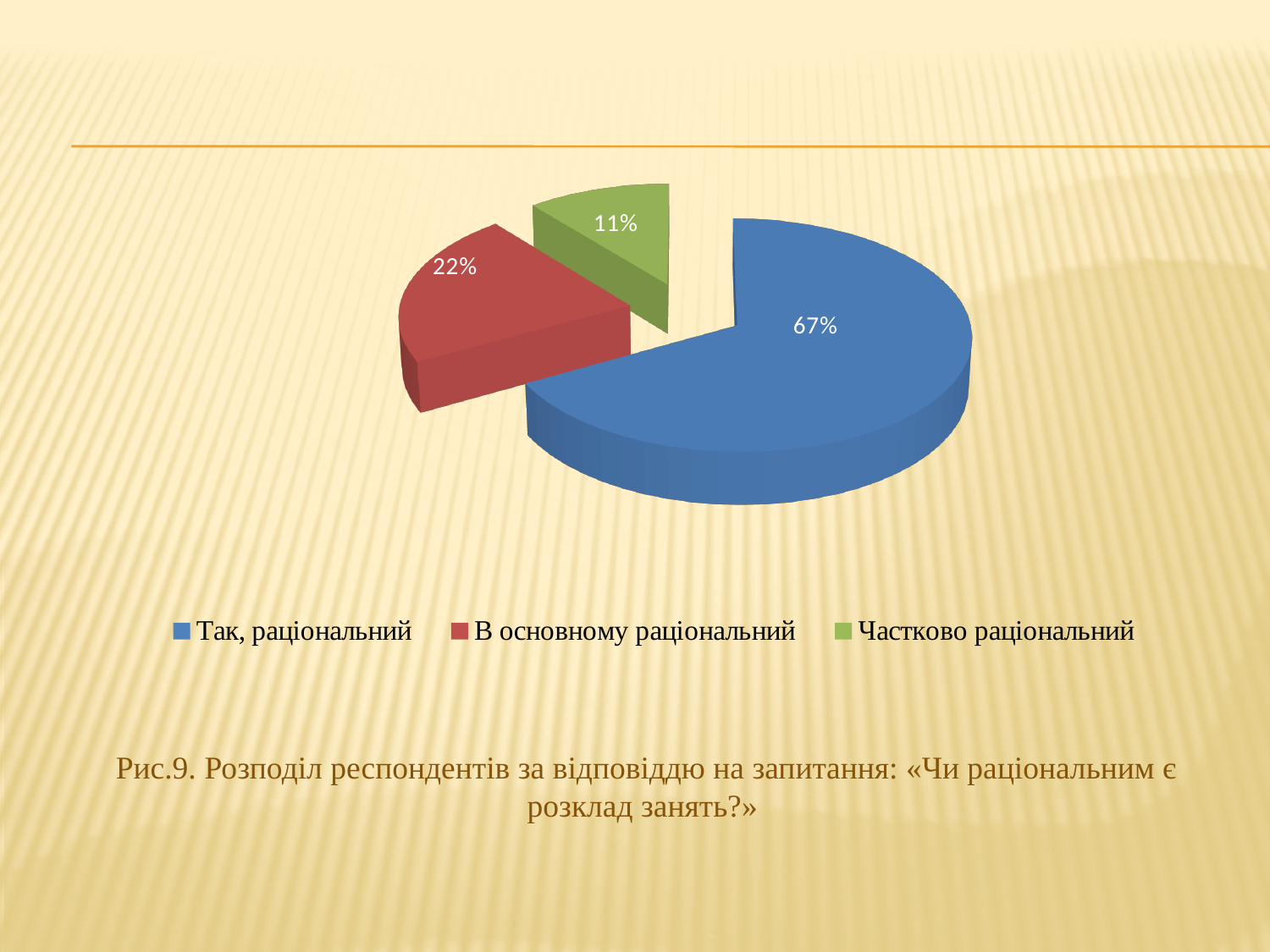
What is the difference in percentage points between "В основному раціональний" and "Частково раціональний"? 11 Which is larger: the share for "В основному раціональний" or for "Частково раціональний"? В основному раціональний How many slices does the pie chart have? 3 What kind of chart is shown on the slide? Pie chart Which answer has the smallest share of respondents? Частково раціональний What colour is the slice for "Так, раціональний"? Blue What share of respondents answered "В основному раціональний"? 22% What is the figure number given in the caption below the chart? Рис.9 What is the difference in percentage points between "Так, раціональний" and "В основному раціональний"? 45 Which answer has the largest share of respondents? Так, раціональний What share of respondents answered "Частково раціональний"? 11% What share of respondents answered "Так, раціональний"? 67%